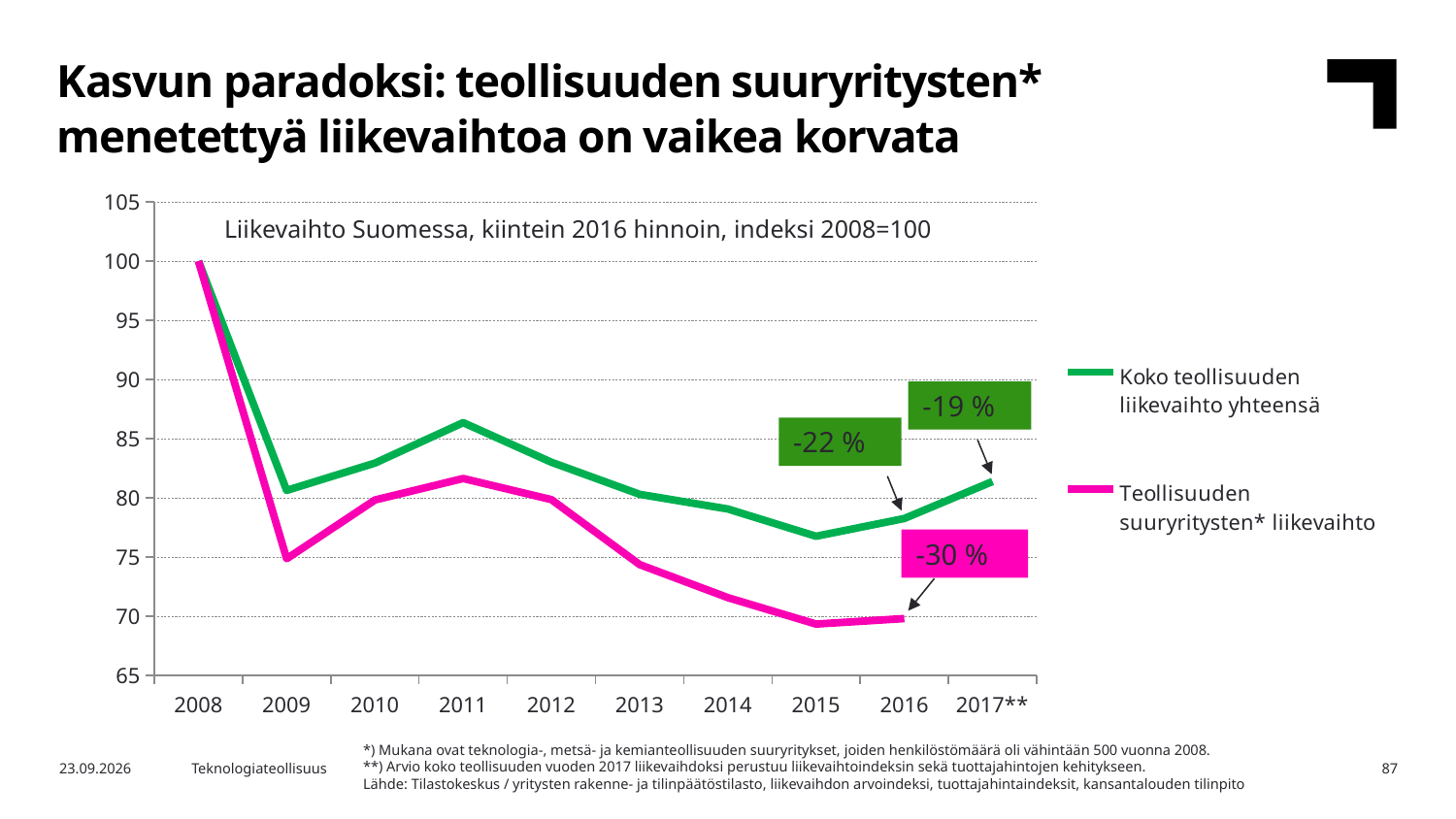
What percentage change is labelled next to the Koko teollisuuden liikevaihto yhteensä line at 2016? -22 % What kind of chart is shown on the slide? line chart Does the Koko teollisuuden liikevaihto yhteensä series rise or fall from 2011 to 2015? fall How many series does the legend list? 2 In which year does the Koko teollisuuden liikevaihto yhteensä series reach its lowest value? 2015 How many years are shown on the x axis? 10 What percentage change is labelled next to the Teollisuuden suuryritysten* liikevaihto line at 2016? -30 % What percentage change is labelled next to the Koko teollisuuden liikevaihto yhteensä line at 2017**? -19 % Is the value for Koko teollisuuden liikevaihto yhteensä in 2015 greater or less than 80? less Is the value for Teollisuuden suuryritysten* liikevaihto in 2015 greater or less than 75? less What is the index value of both series in 2008? 100 Which series has the higher value in 2016? Koko teollisuuden liikevaihto yhteensä